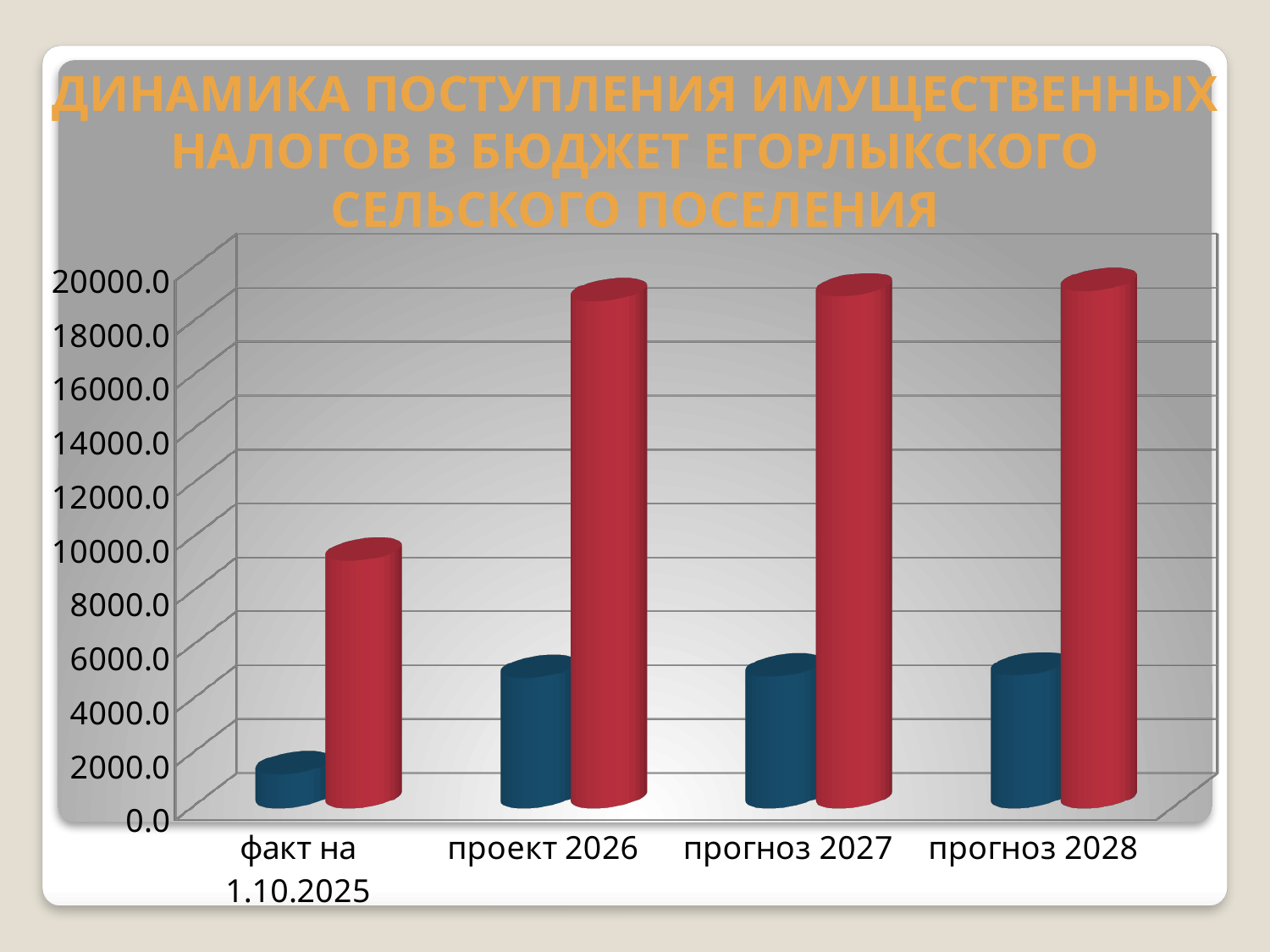
Which category has the lowest red bar? факт на 1.10.2025 How many bars are shown for each category on the chart? 2 What kind of chart is shown on the slide? bar chart Which category has the lowest blue bar? факт на 1.10.2025 Is the blue bar for проект 2026 greater or less than 8000.0? less How many categories are shown on the x axis of the chart? 4 Is the blue bar for факт на 1.10.2025 greater or less than 4000.0? less Do the red bars rise or fall from факт на 1.10.2025 to проект 2026? rise Which is larger: the red bar for факт на 1.10.2025 or the red bar for проект 2026? проект 2026 Is the red bar for факт на 1.10.2025 greater or less than 8000.0? greater